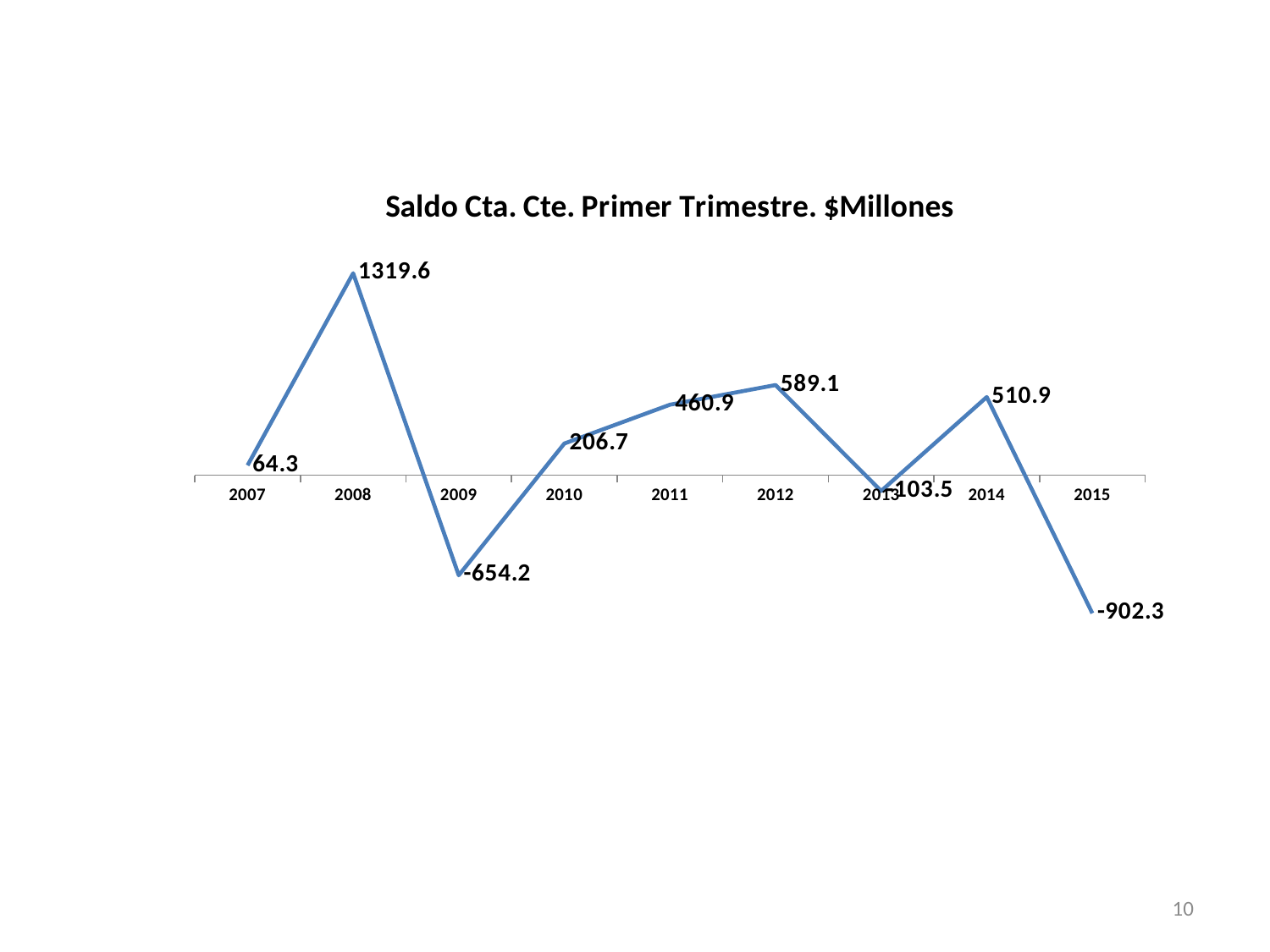
Which year has the lowest value? 2015 What is the value for 2008? 1319.6 Which year has the highest value? 2008 What is the value for 2015? -902.3 What is the difference between the values for 2012 and 2011? 128.2 What is the value for 2011? 460.9 What is the value for 2009? -654.2 What kind of chart is shown? line chart What is the difference between the values for 2008 and 2014? 808.7 How many years are plotted on the x axis? 9 Do the values rise or fall from 2010 to 2012? rise Which is larger, the value for 2012 or the value for 2014? 2012